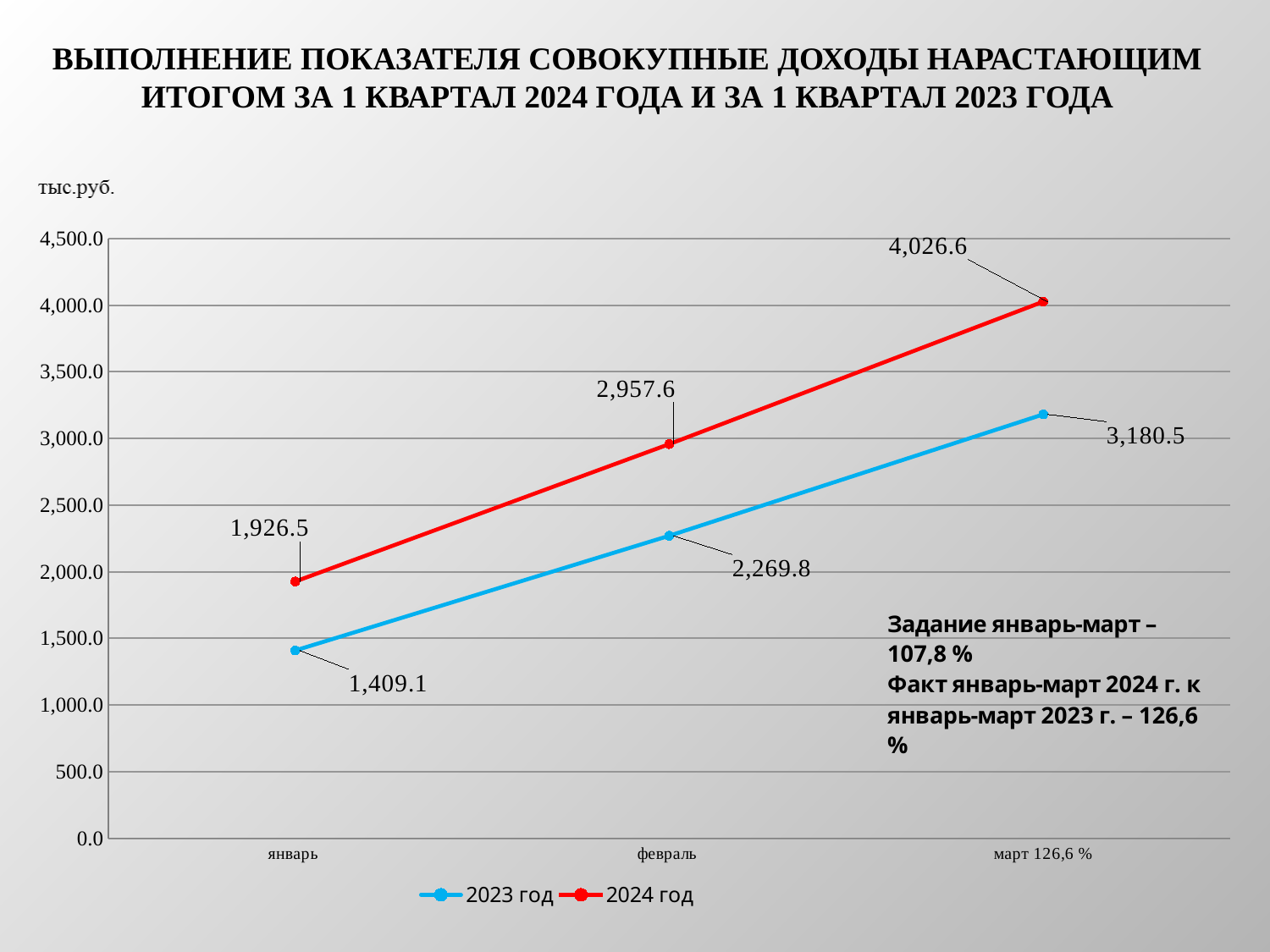
In which month is the 2024 год series lowest? январь What is the difference between the 2024 год and 2023 год values in март? 846.1 What is the value for 2024 год in февраль? 2,957.6 What type of chart is shown on the slide? line chart Do the values of the 2024 год series rise or fall from январь to март? rise How many series does the legend list? 2 What is the value for 2024 год in март? 4,026.6 In which month is the 2023 год series highest? март What is the value for 2023 год in январь? 1,409.1 What unit is shown above the vertical axis? тыс.руб. What is the value for 2023 год in февраль? 2,269.8 Which is larger in январь: the 2023 год value or the 2024 год value? 2024 год